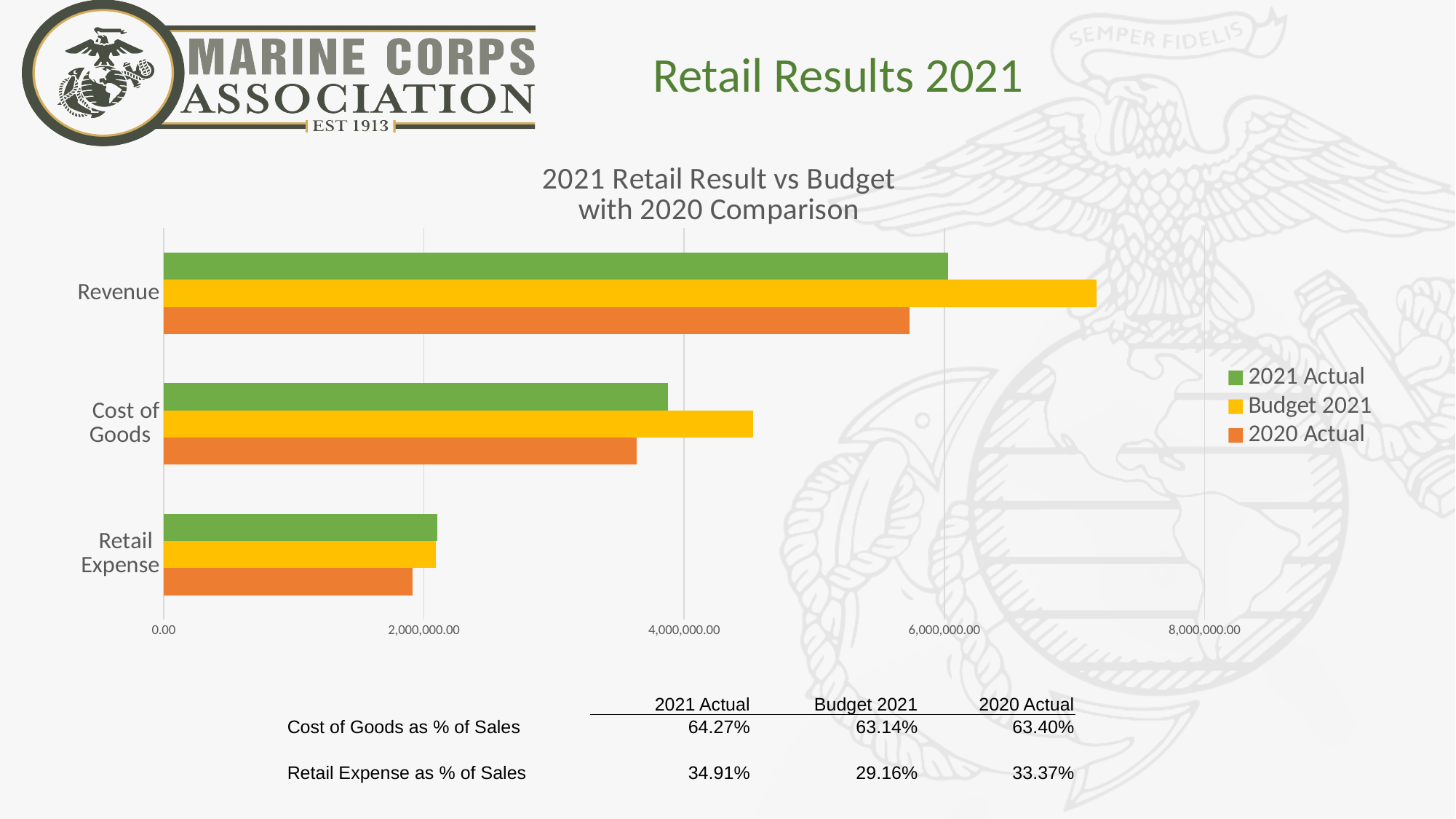
What is the title of the chart? 2021 Retail Result vs Budget with 2020 Comparison Is the 2020 Actual value for Retail Expense greater or less than 2,000,000.00? less Is the Budget 2021 value for Cost of Goods greater or less than 4,000,000.00? greater Is the Budget 2021 value for Revenue greater or less than 6,000,000.00? greater Which series has the highest Revenue bar? Budget 2021 Which series has the highest Cost of Goods bar? Budget 2021 How many categories are plotted on the chart? 3 For Revenue, which is larger: 2021 Actual or 2020 Actual? 2021 Actual Which colour represents the 2020 Actual series in the chart? orange Which series has the lowest Retail Expense bar? 2020 Actual How many series does the chart legend list? 3 What kind of chart is shown on the slide? bar chart